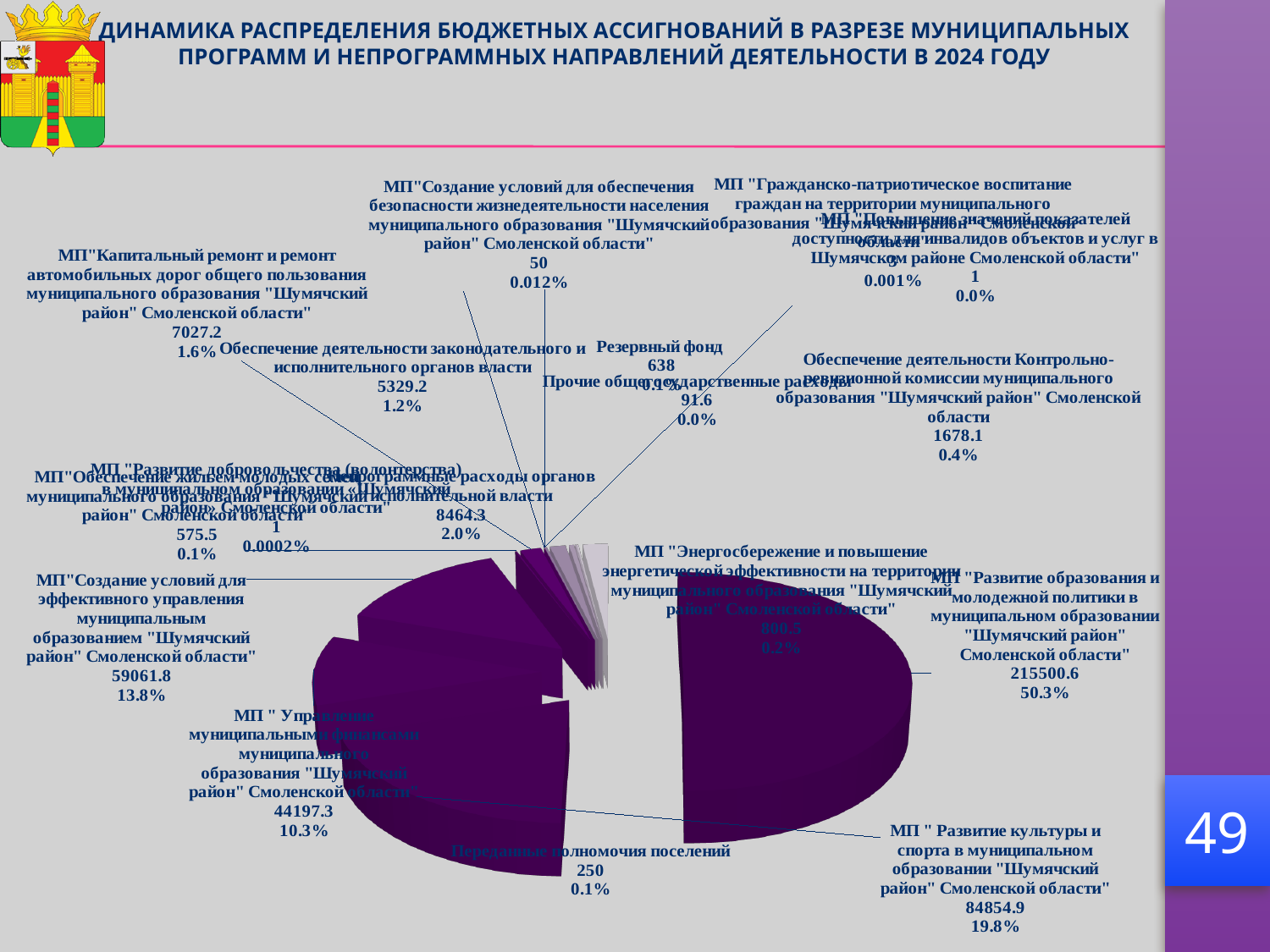
What is the difference between the values for МП "Развитие образования и молодежной политики" (215500.6) and МП "Развитие культуры и спорта" (84854.9)? 130645.7 Which is larger: the value for МП "Создание условий для эффективного управления муниципальным образованием" or the value for МП "Управление муниципальными финансами"? МП "Создание условий для эффективного управления муниципальным образованием" What share of the pie does МП "Развитие образования и молодежной политики" account for? 50.3% What kind of chart is shown on the slide? pie chart What percentage is shown for МП "Управление муниципальными финансами"? 10.3% What value is shown for МП "Развитие культуры и спорта в муниципальном образовании "Шумячский район" Смоленской области"? 84854.9 What percentage is shown for Обеспечение деятельности Контрольно-ревизионной комиссии? 0.4% What value is shown for МП "Развитие образования и молодежной политики в муниципальном образовании "Шумячский район" Смоленской области"? 215500.6 What year does the slide title say the budget allocation dynamics refer to? 2024 Which category has the largest slice of the pie? МП "Развитие образования и молодежной политики в муниципальном образовании "Шумячский район" Смоленской области" What value is shown for Резервный фонд? 638 What value is shown for Переданные полномочия поселений? 250